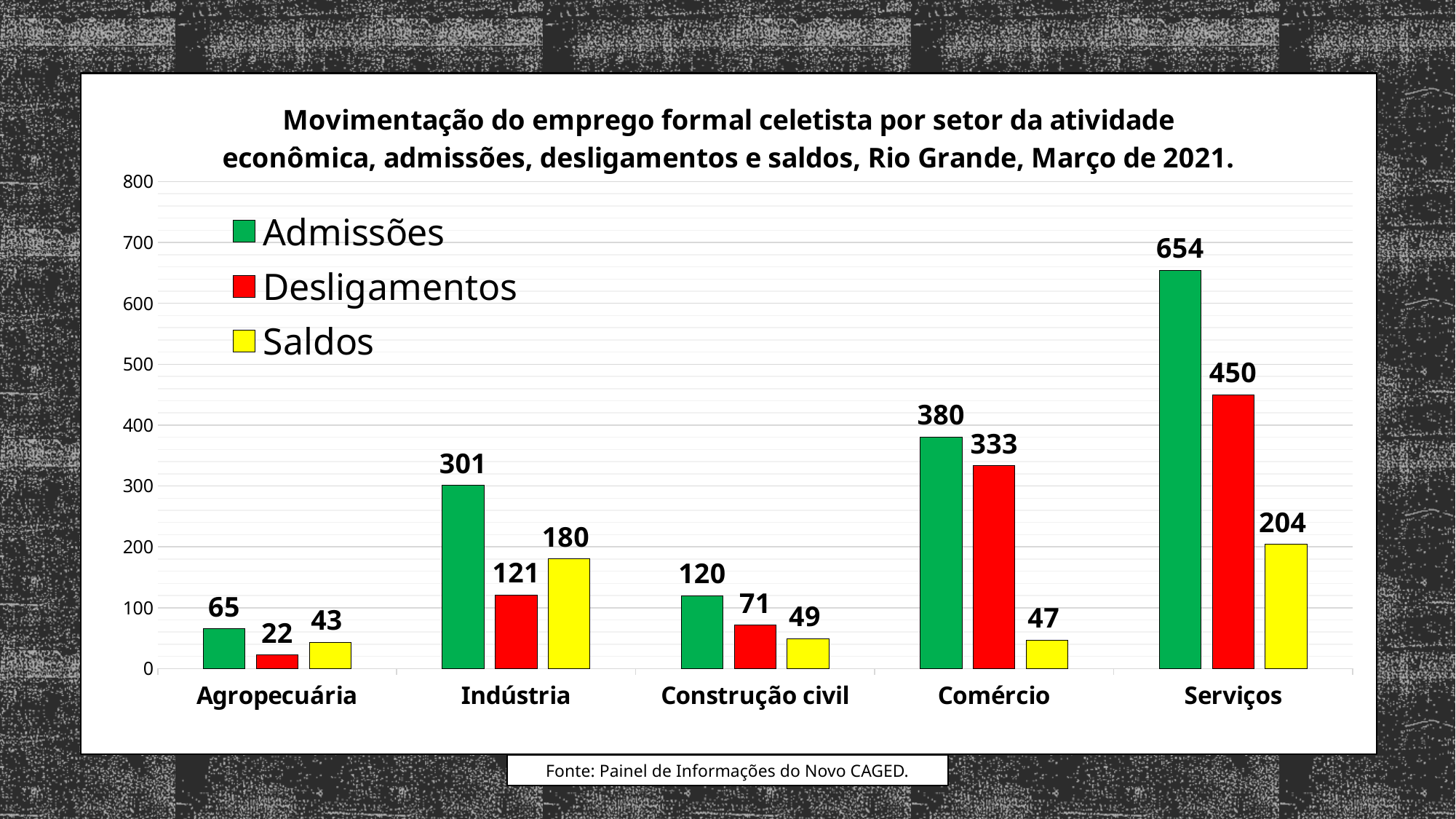
How many series does the legend list? 3 Which sector has the highest value for Admissões? Serviços How many sectors are shown on the x axis? 5 Which is larger for Construção civil: Admissões or Desligamentos? Admissões What kind of chart is shown on the slide? Bar chart What is the value of Saldos for Indústria? 180 Which sector has the lowest value for Desligamentos? Agropecuária Is the value of Desligamentos for Serviços greater or less than 400? greater What is the value of Desligamentos for Comércio? 333 What is the value of Admissões for Serviços? 654 What is the difference between Admissões and Desligamentos for Comércio? 47 What colour represents the Saldos series? Yellow